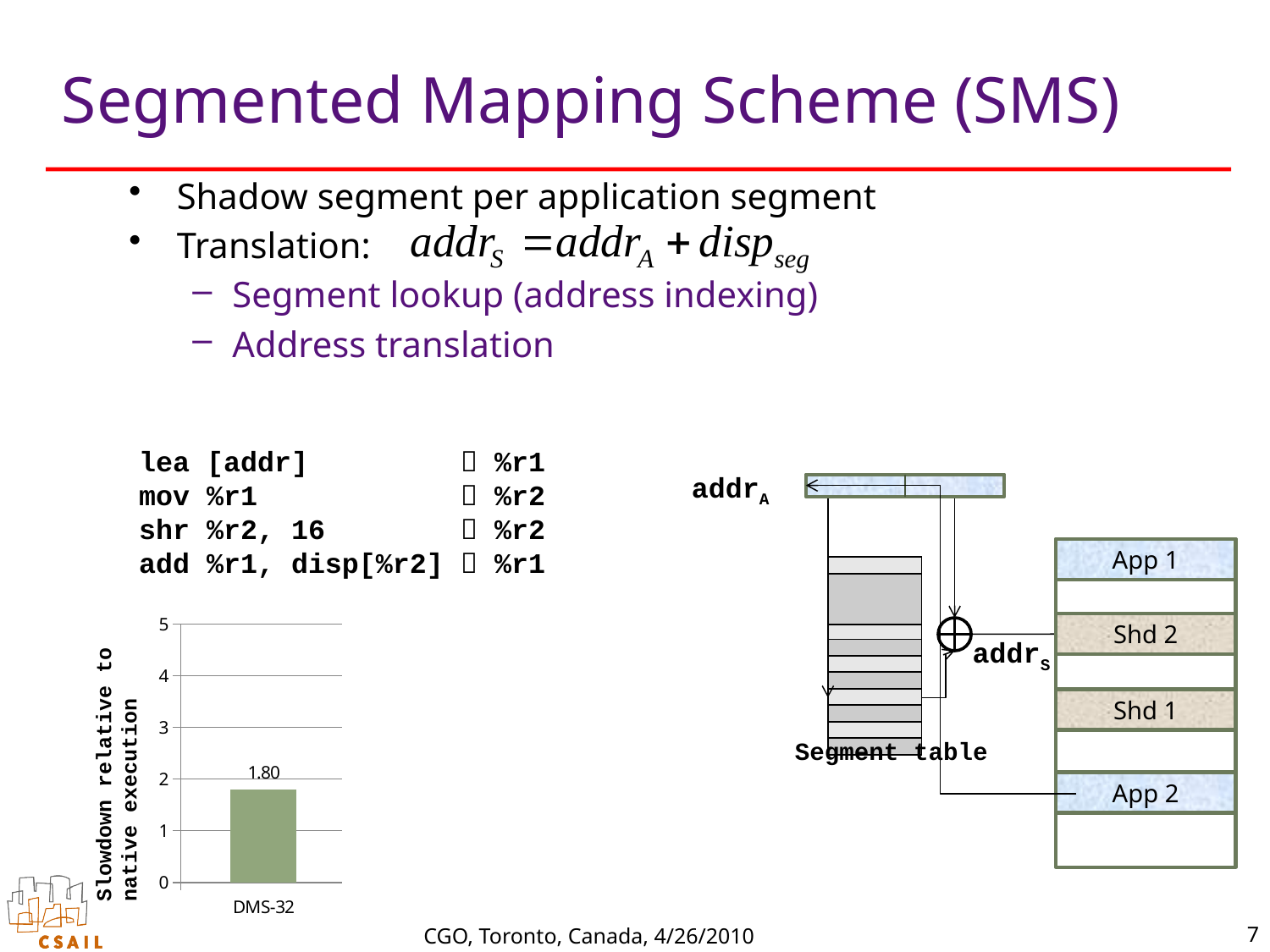
What is the category label on the x axis of the bar chart? DMS-32 Is the value for DMS-32 greater or less than 1? greater Is the value for DMS-32 greater or less than 2? less What is the highest value shown on the y axis of the bar chart? 5 How many bars does the chart show? 1 What is the label of the y axis of the bar chart? Slowdown relative to native execution What is the slowdown value shown for DMS-32 in the bar chart? 1.80 What kind of chart is shown at the bottom left of the slide? bar chart